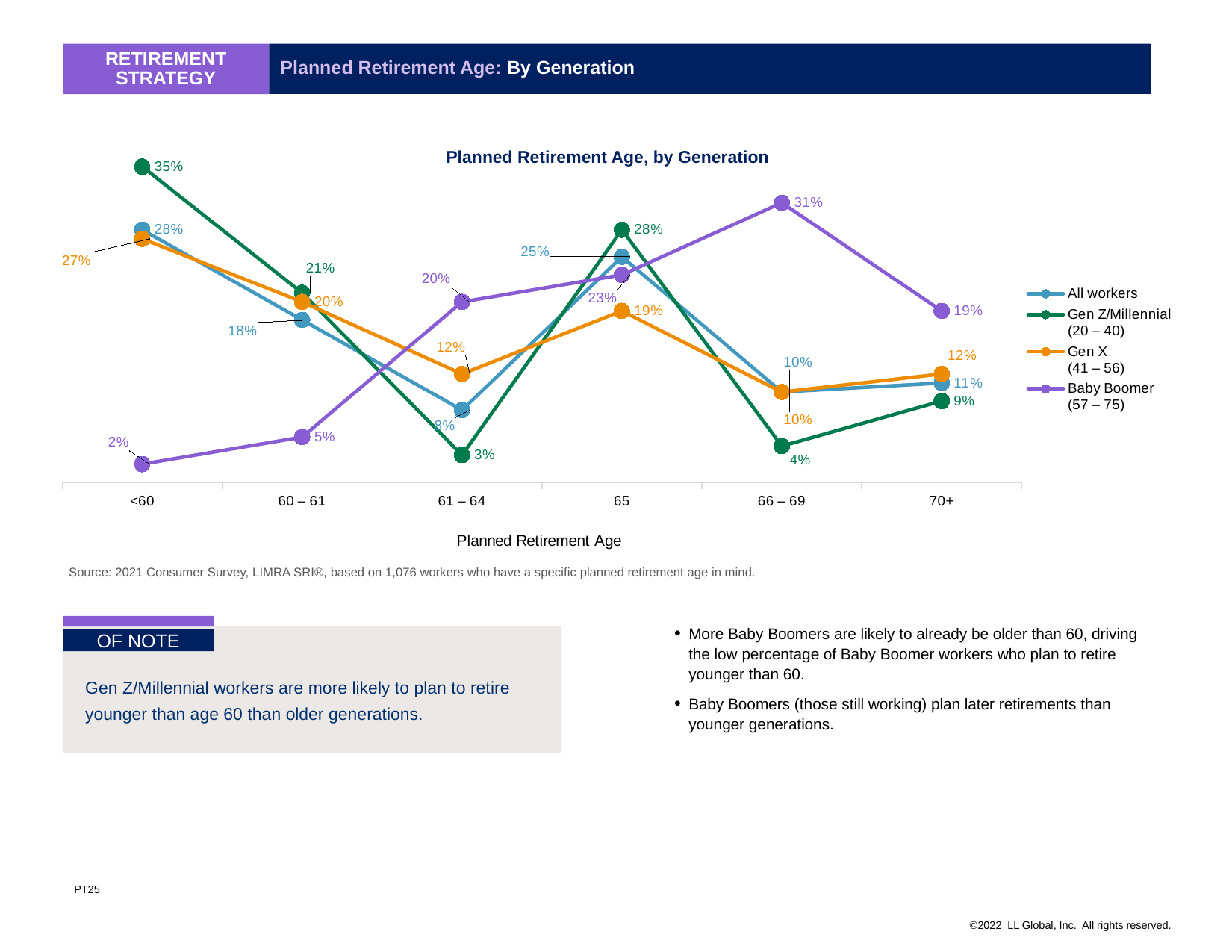
What is the title of the chart? Planned Retirement Age, by Generation Which generation has the highest value in the <60 category? Gen Z/Millennial (20 – 40) How many series does the legend list? 4 What is the value for All workers at age 65? 25% Which generation has the lowest value in the 66 – 69 category? Gen Z/Millennial (20 – 40) What is the difference between the Baby Boomer and Gen Z/Millennial values in the 70+ category? 10% What is the value for Gen X in the 61 – 64 category? 12% What type of chart is shown on the slide? Line chart At age 65, which is larger: the Gen Z/Millennial value or the Gen X value? Gen Z/Millennial What is the value for Baby Boomers in the 66 – 69 category? 31% How many planned retirement age categories are shown on the x axis? 6 What percentage of Gen Z/Millennial workers plan to retire before age 60? 35%